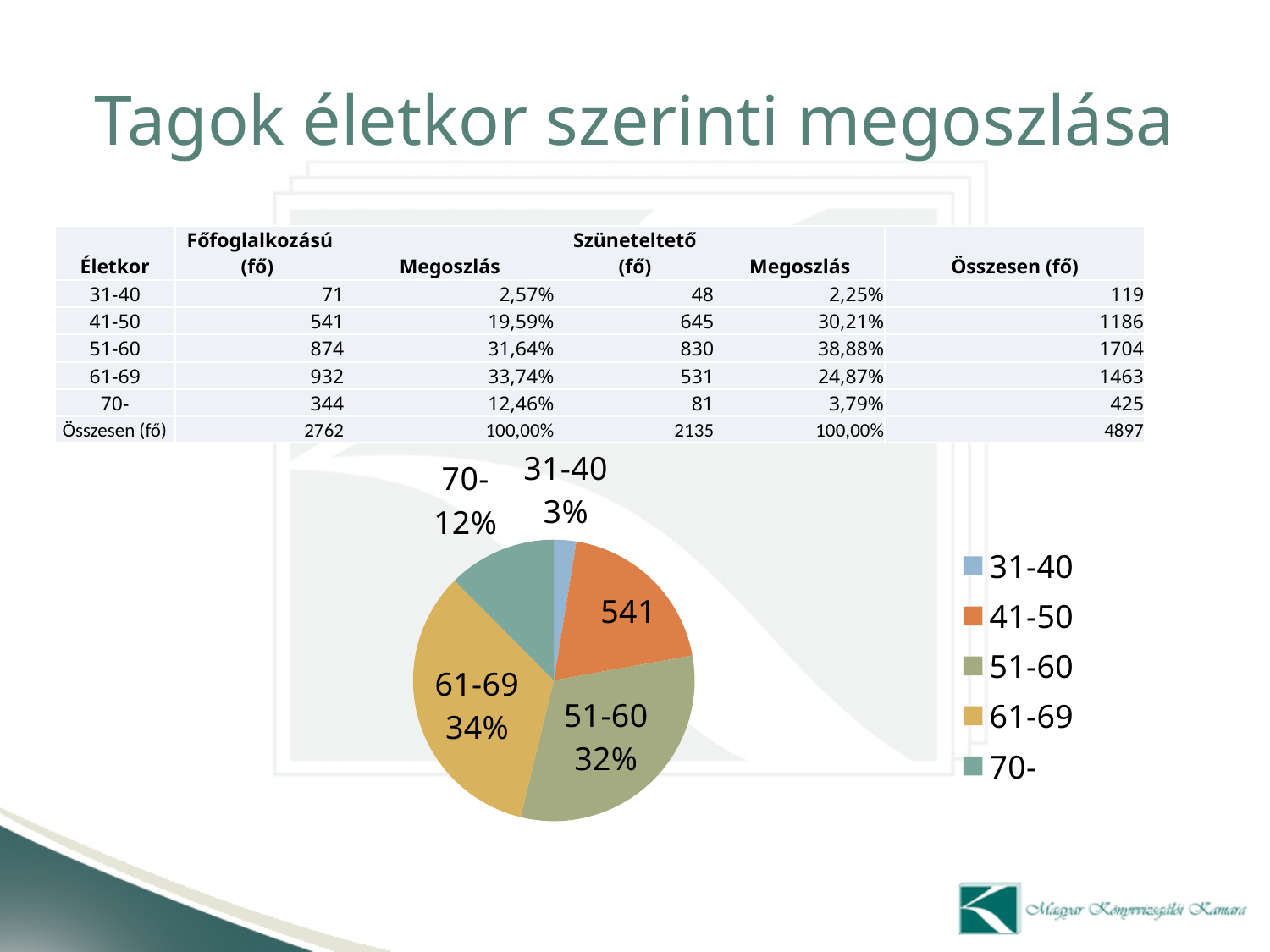
Which slice is larger in the pie chart, 51-60 or 70-? 51-60 What kind of chart is shown on the slide? pie chart What share of the pie does the 51-60 age group have? 32% Which age group has the largest slice in the pie chart? 61-69 What share of the pie does the 61-69 age group have? 34% Which age group has the smallest slice in the pie chart? 31-40 In the pie chart, what is the difference in percentage points between the 61-69 slice and the 70- slice? 22 What value is printed on the 41-50 slice of the pie chart? 541 How many entries does the legend of the pie chart list? 5 How many slices does the pie chart have? 5 What share of the pie does the 70- age group have? 12%